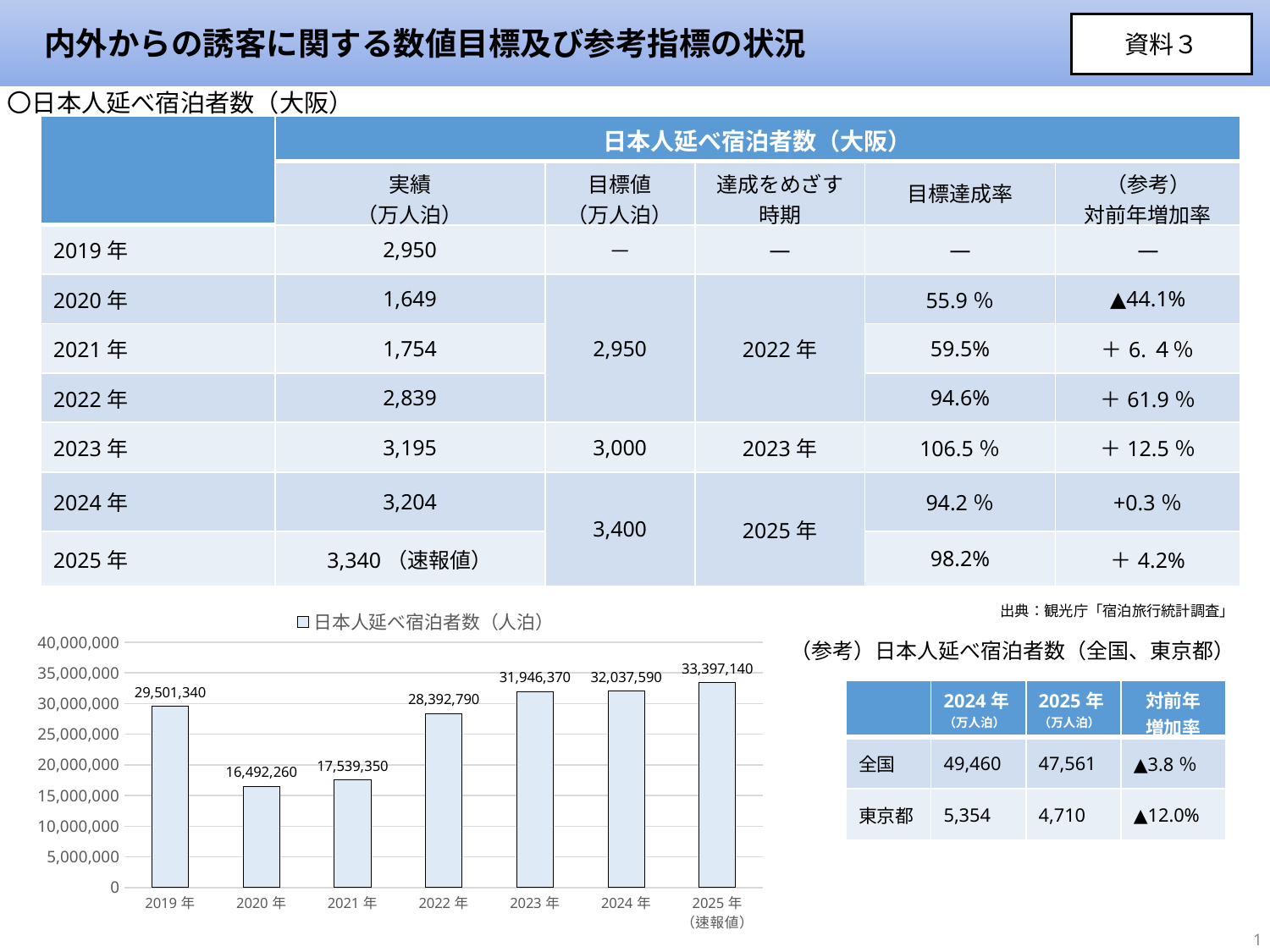
What is the value for 2025年（速報値） in the bar chart? 33,397,140 Is the value for 2023年 in the bar chart greater or less than 30,000,000? greater What is the difference between the values for 2021年 and 2020年 in the bar chart? 1,047,090 What is the difference between the values for 2025年（速報値） and 2024年 in the bar chart? 1,359,550 What is the value for 2019年 in the bar chart? 29,501,340 What is the value for 2022年 in the bar chart? 28,392,790 Which year has the highest value in the bar chart? 2025年（速報値） What kind of chart is shown at the bottom left of the slide? bar chart Which year has the lowest value in the bar chart? 2020年 In the bar chart, which is larger, the value for 2019年 or the value for 2022年? 2019年 What is the legend entry of the bar chart? 日本人延べ宿泊者数（人泊） How many years are shown on the x axis of the bar chart? 7